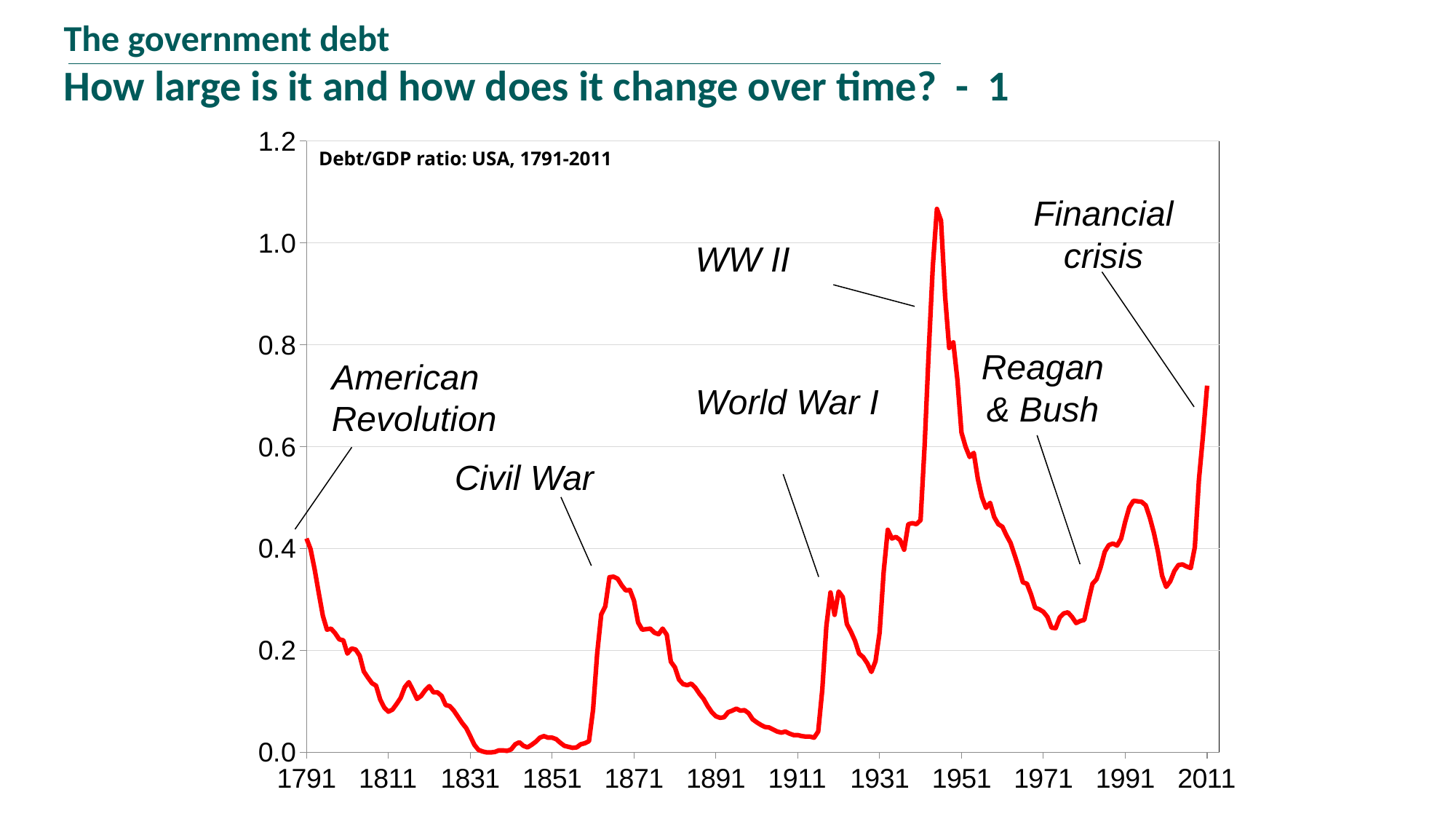
Is the Debt/GDP ratio in 2011 greater or less than 0.6? greater Is the Debt/GDP ratio around 1851 greater or less than 0.2? less What kind of chart is shown on the slide? line chart Is the Debt/GDP ratio around 1971 greater or less than 0.4? less Which peak is higher: the one at WW II or the one at the Civil War? WW II Does the Debt/GDP ratio rise or fall between 1791 and 1831? fall What colour is the plotted line? red Which annotated event corresponds to the highest peak of the Debt/GDP ratio? WW II How many historical events are annotated on the chart? 6 What is the title printed inside the chart area? Debt/GDP ratio: USA, 1791-2011